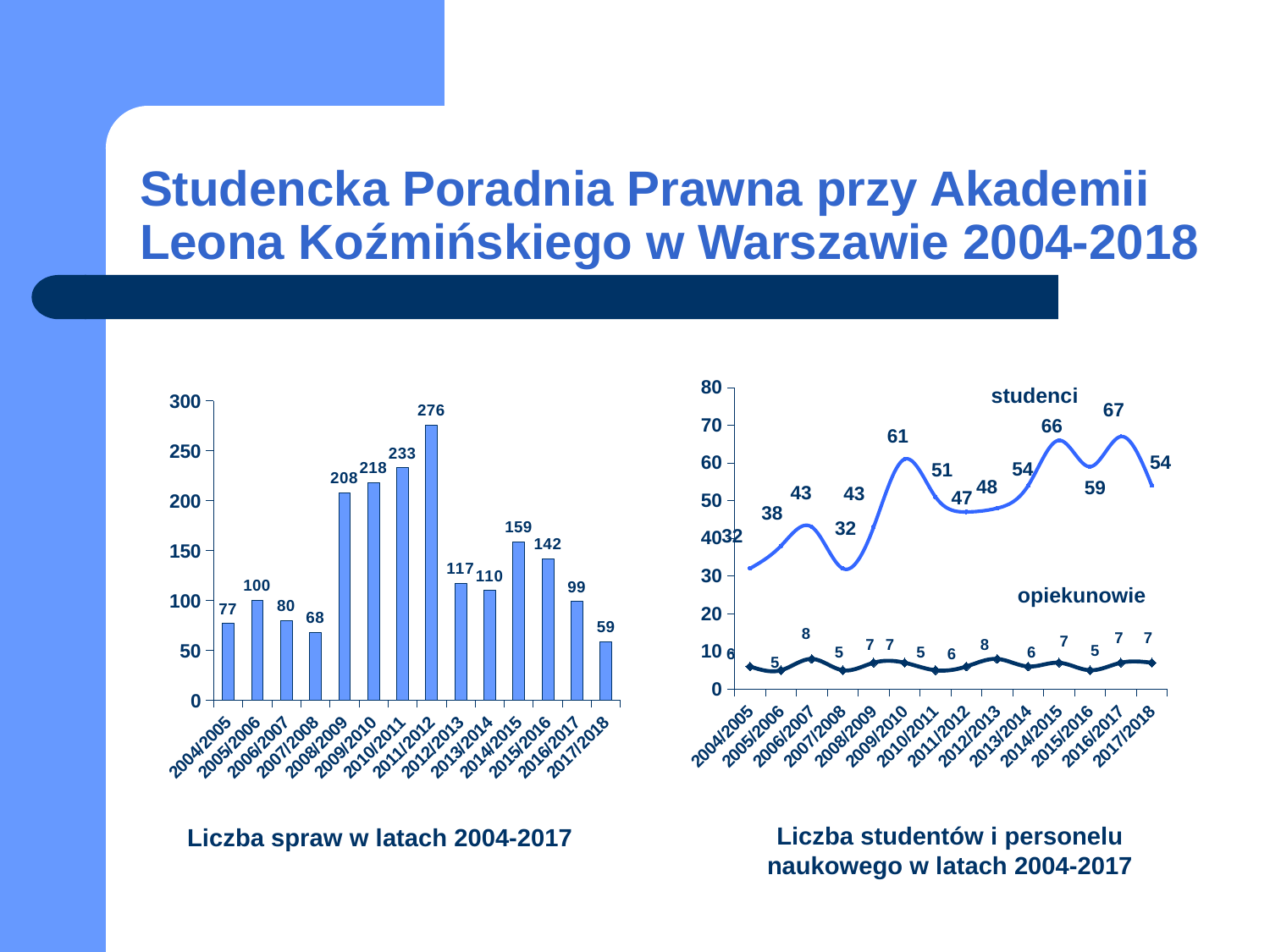
In the left chart (Liczba spraw w latach 2004-2017), which year has the lowest value? 2017/2018 In the left chart (Liczba spraw w latach 2004-2017), which is larger, the value for 2014/2015 or 2015/2016? 2014/2015 In the left chart (Liczba spraw w latach 2004-2017), what is the value for 2011/2012? 276 In the right chart (Liczba studentów i personelu naukowego), which year has the highest value for studenci? 2016/2017 In the left chart (Liczba spraw w latach 2004-2017), which year has the highest value? 2011/2012 What kind of chart is the right chart (Liczba studentów i personelu naukowego)? line chart What kind of chart is the left chart (Liczba spraw w latach 2004-2017)? bar chart In the left chart (Liczba spraw w latach 2004-2017), what is the difference between the values for 2010/2011 and 2009/2010? 15 In the right chart (Liczba studentów i personelu naukowego), what is the value of opiekunowie for 2006/2007? 8 In the right chart (Liczba studentów i personelu naukowego), how many series are plotted? 2 In the right chart (Liczba studentów i personelu naukowego), what is the value of studenci for 2009/2010? 61 In the left chart (Liczba spraw w latach 2004-2017), how many years are shown on the x axis? 14